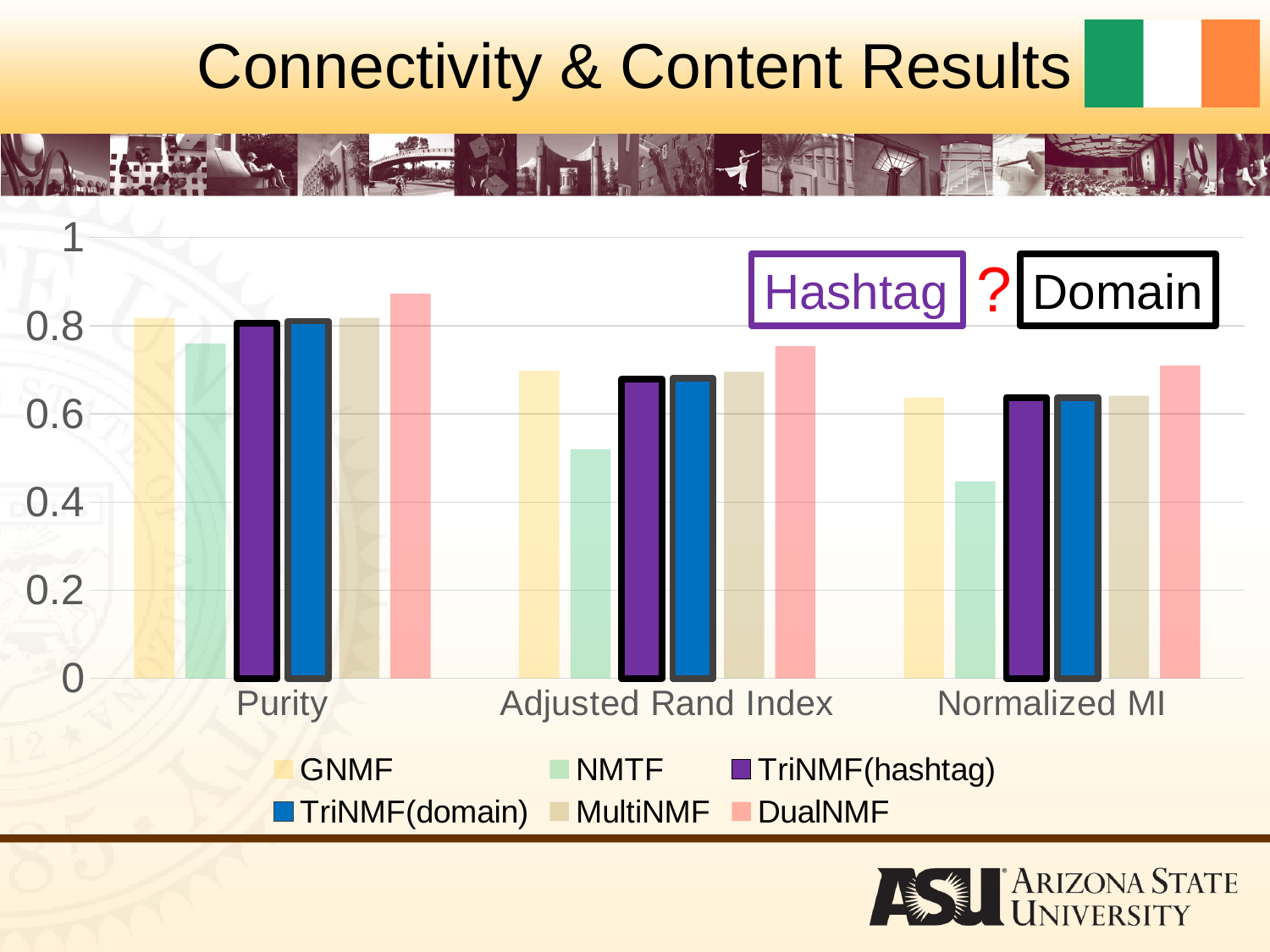
Is the value for NMTF in Adjusted Rand Index greater or less than 0.6? less Is the value for NMTF in Normalized MI greater or less than 0.6? less Which series has the lowest value for Normalized MI? NMTF Which is larger for Purity: the value for DualNMF or the value for NMTF? DualNMF What kind of chart is shown on the slide? bar chart Is the value for DualNMF in Purity greater or less than 0.8? greater How many categories are shown on the x axis of the chart? 3 Which series has the highest value for Purity? DualNMF Which series has the lowest value for Adjusted Rand Index? NMTF Do the values for DualNMF rise or fall from Purity to Normalized MI along the x axis? fall What is the title of the slide containing the chart? Connectivity & Content Results How many series does the chart's legend list? 6